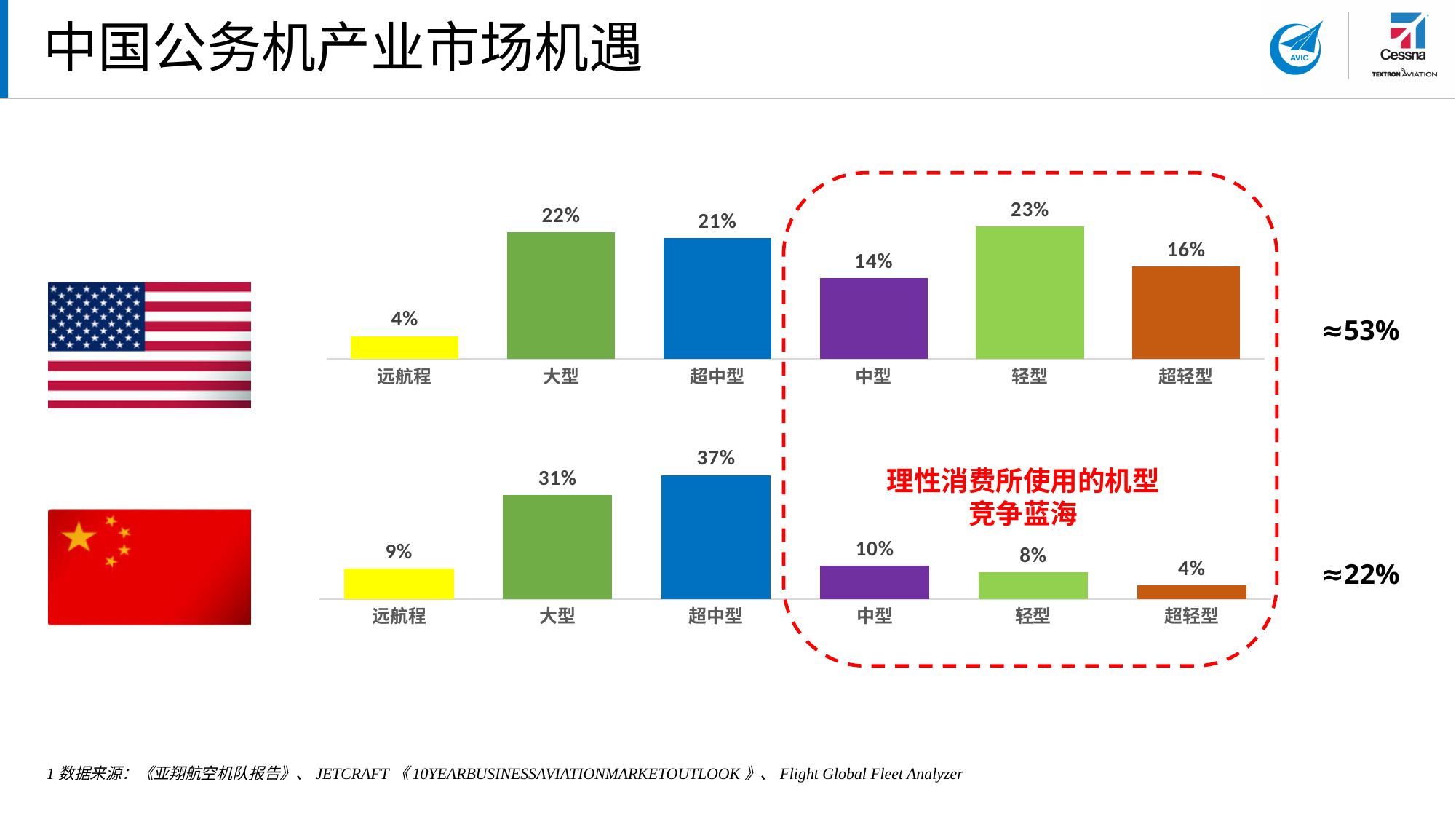
In the bottom chart (China flag), which is larger, 中型 or 轻型? 中型 In the bottom chart (China flag), what is the value for 远航程? 9% In the top chart (US flag), which category has the lowest value? 远航程 What is the total of 中型, 轻型 and 超轻型 in the bottom chart (China flag)? 22% In the bottom chart (China flag), what is the value for 超中型? 37% What kind of chart is the bottom chart (China flag)? bar chart In the bottom chart (China flag), which category has the lowest value? 超轻型 In the top chart (US flag), what is the value for 大型? 22% In the top chart (US flag), which category has the highest value? 轻型 How many categories does the top chart (US flag) show? 6 In the bottom chart (China flag), what is the difference between 超中型 and 大型? 6% In the top chart (US flag), what is the difference between 轻型 and 超轻型? 7%